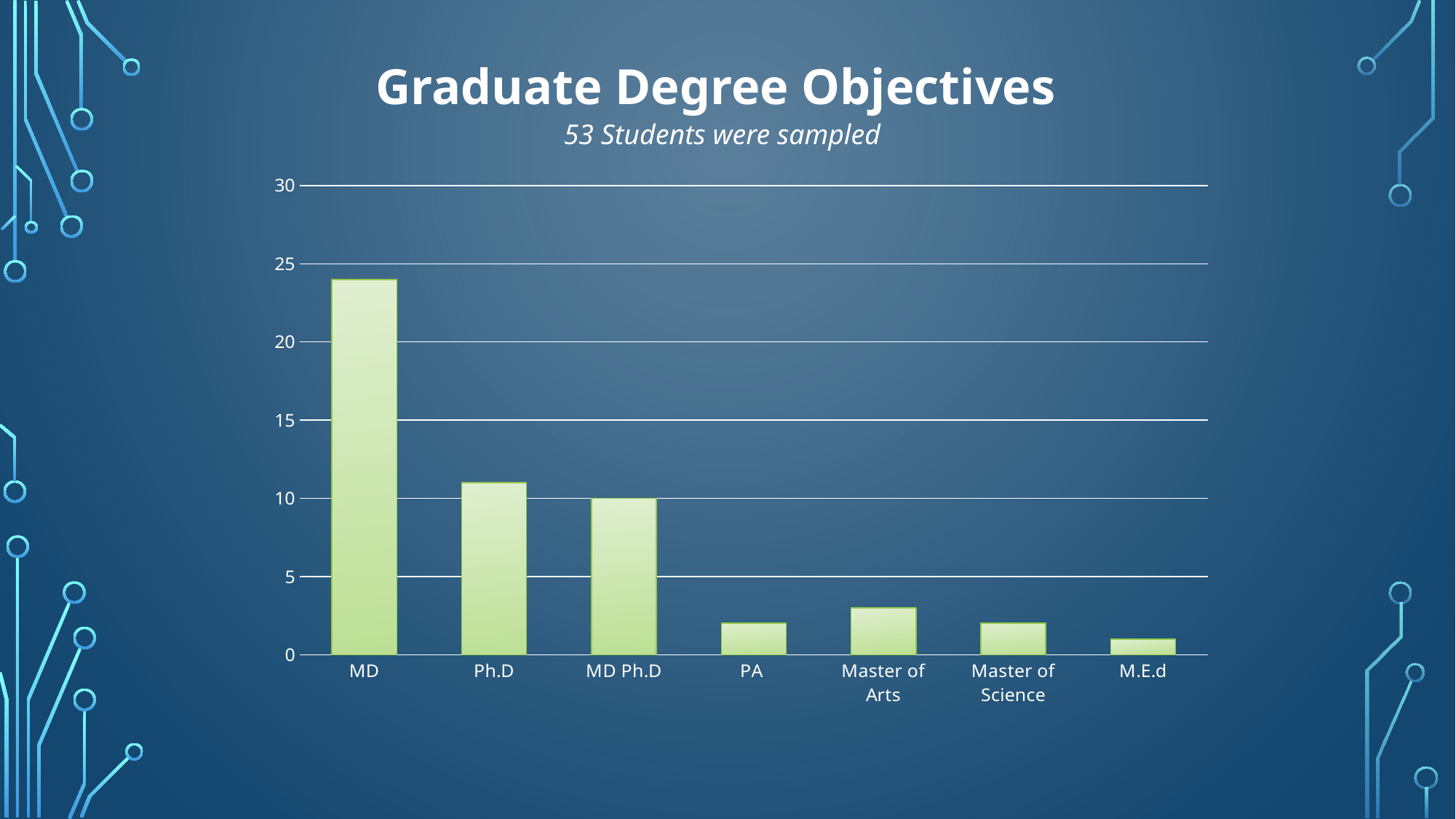
Is the value for MD greater or less than 25? less How many degree categories are shown on the x axis? 7 Which is larger, the value for MD or the value for Ph.D? MD Which is larger, the value for Master of Arts or the value for PA? Master of Arts What is the title of the chart? Graduate Degree Objectives What kind of chart is shown on the slide? bar chart Is the value for MD greater or less than 20? greater Which degree objective has the highest bar? MD What is the value for MD Ph.D? 10 Is the value for PA greater or less than 5? less Which degree objective has the lowest bar? M.E.d How many students were sampled, according to the subtitle? 53